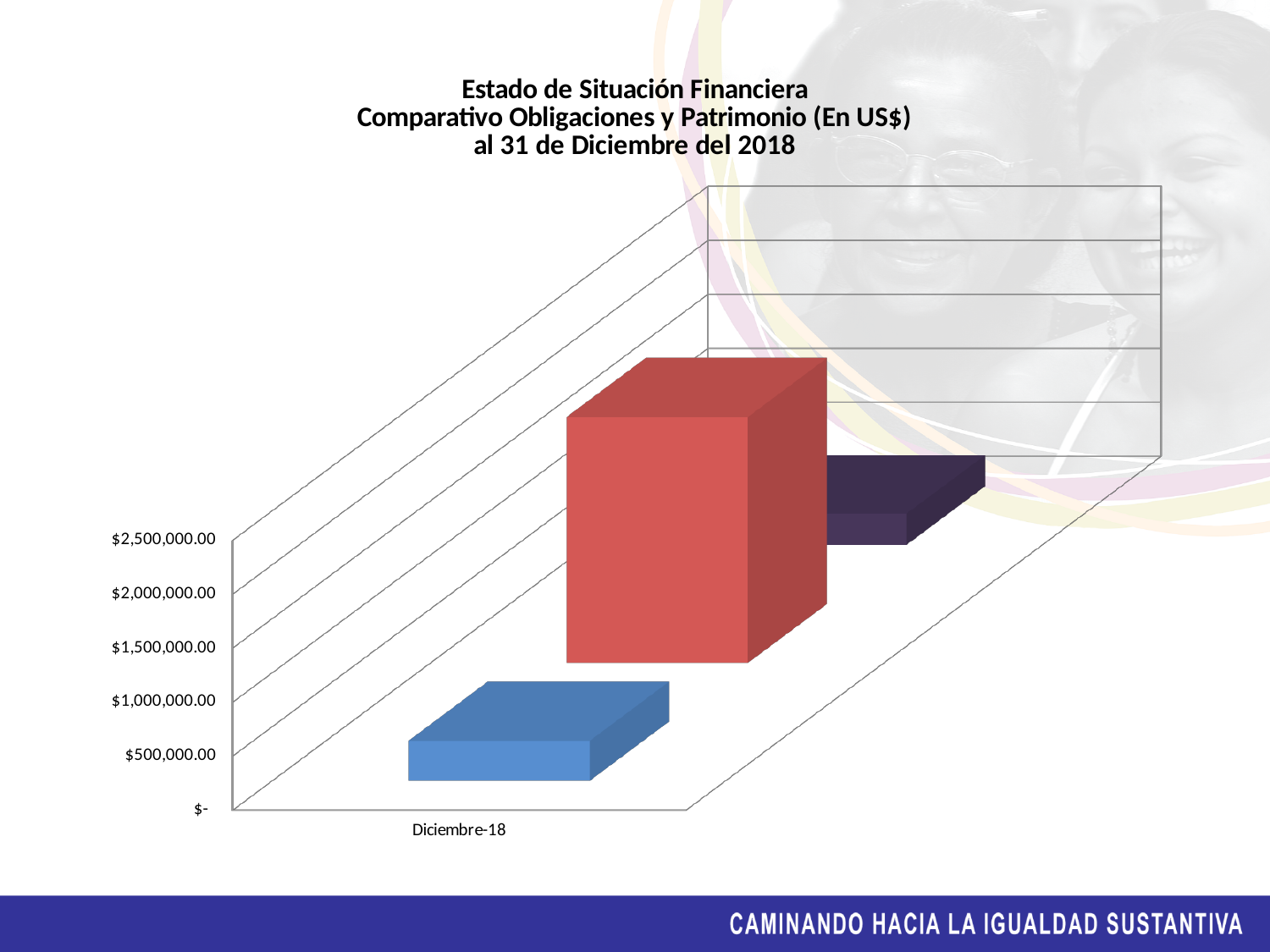
What is the highest value labelled on the vertical axis of the chart? $2,500,000.00 Which is larger, the red bar or the purple bar? the red bar Is the value of the blue bar greater or less than $1,000,000.00? less What kind of chart is shown on the slide? bar chart Is the value of the red bar greater or less than $500,000.00? greater What is the category label shown on the x axis of the chart? Diciembre-18 Is the value of the purple bar greater or less than $1,000,000.00? less Which coloured bar is the tallest in the chart? the red bar Which is larger, the red bar or the blue bar? the red bar How many bars are plotted in the chart? 3 How many categories are shown on the x axis of the chart? 1